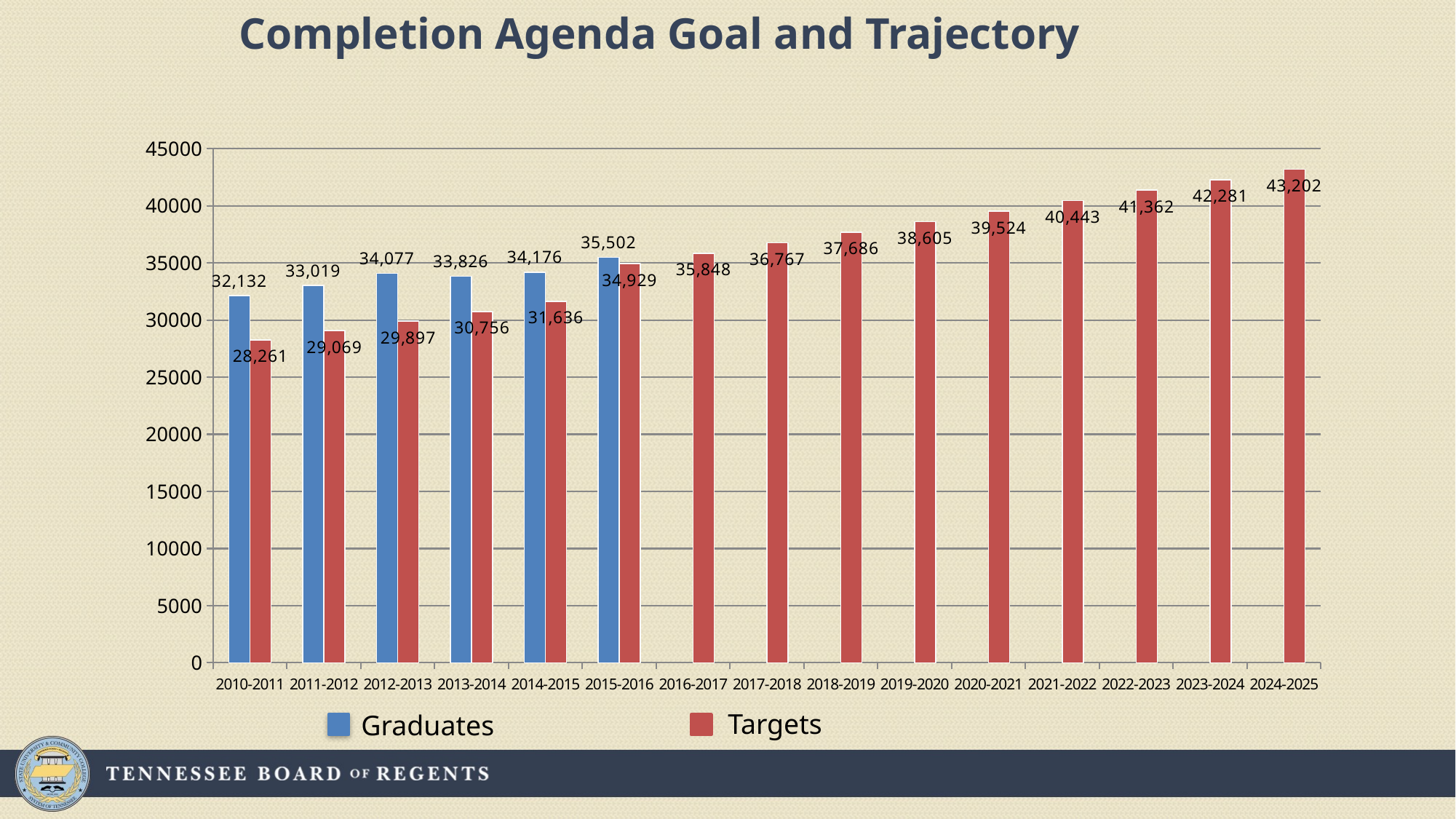
What is the Targets value for 2018-2019? 37,686 In which year is the Graduates value highest? 2015-2016 Is the Targets value for 2020-2021 greater or less than 40000? less In 2013-2014, which is larger, Graduates or Targets? Graduates What is the Targets value for 2024-2025? 43,202 By how much does the Graduates value exceed the Targets value in 2015-2016? 573 What is the value for Graduates in 2010-2011? 32,132 What is the difference between the Graduates values for 2012-2013 and 2011-2012? 1,058 In which year is the Targets value lowest? 2010-2011 How many academic years are shown on the x axis? 15 What kind of chart is shown on the slide? bar chart How many series does the legend list? 2